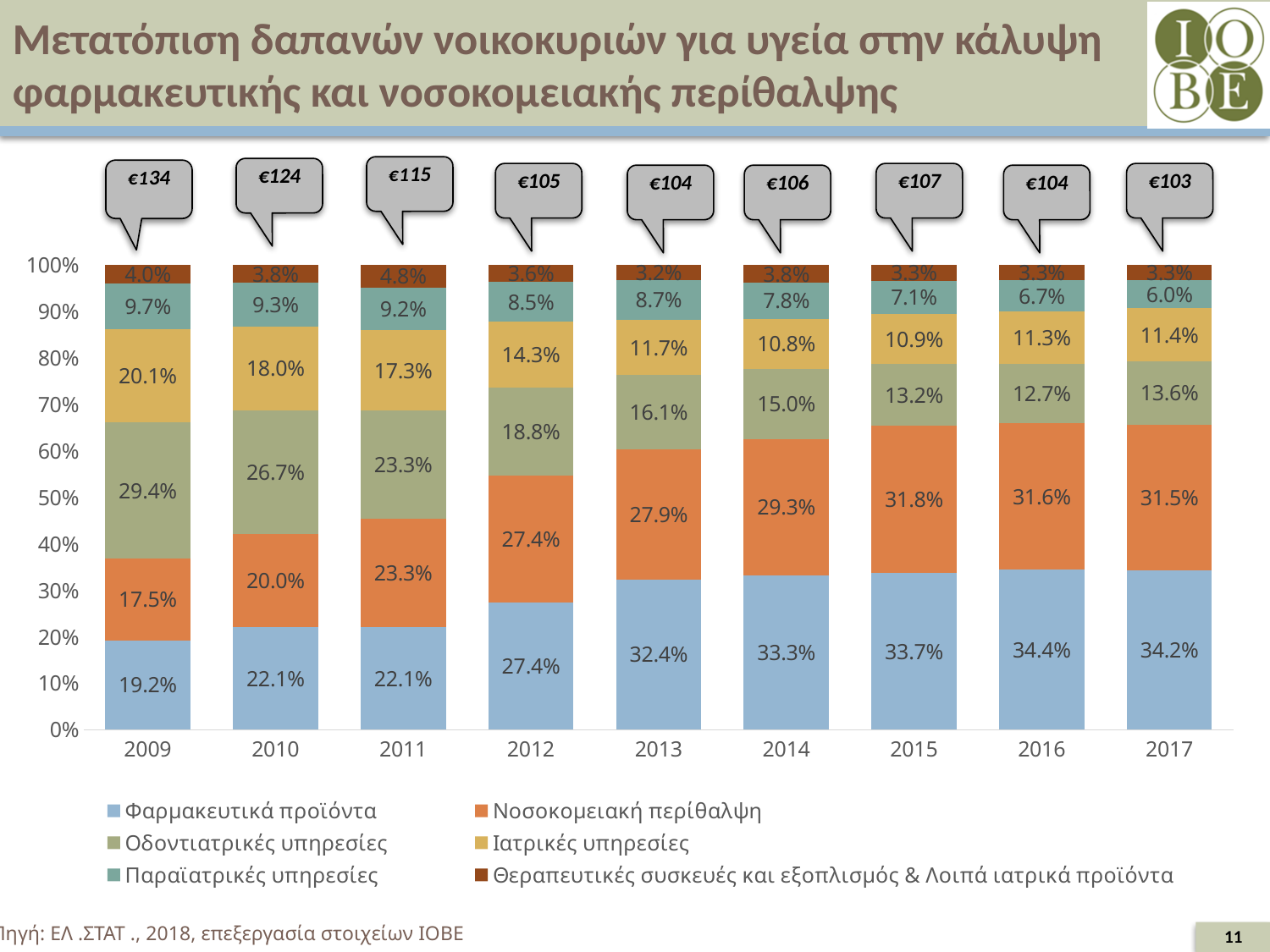
In 2009, which is larger: the share of Οδοντιατρικές υπηρεσίες or the share of Νοσοκομειακή περίθαλψη? Οδοντιατρικές υπηρεσίες What euro amount is shown in the callout above the 2009 bar? €134 By how many percentage points did the share of Φαρμακευτικά προϊόντα change from 2009 to 2017? 15.0 percentage points What is the share of Νοσοκομειακή περίθαλψη in 2017? 31.5% Does the share of Φαρμακευτικά προϊόντα generally rise or fall from 2009 to 2017? Rise How many years are shown on the x axis? 9 What percentage share do Φαρμακευτικά προϊόντα have in 2009? 19.2% In which year is the share of Παραϊατρικές υπηρεσίες the lowest? 2017 What kind of chart is shown on the slide? Stacked bar chart In which year is the share of Οδοντιατρικές υπηρεσίες the highest? 2009 How many series does the legend list? 6 What is the share of Οδοντιατρικές υπηρεσίες in 2012? 18.8%